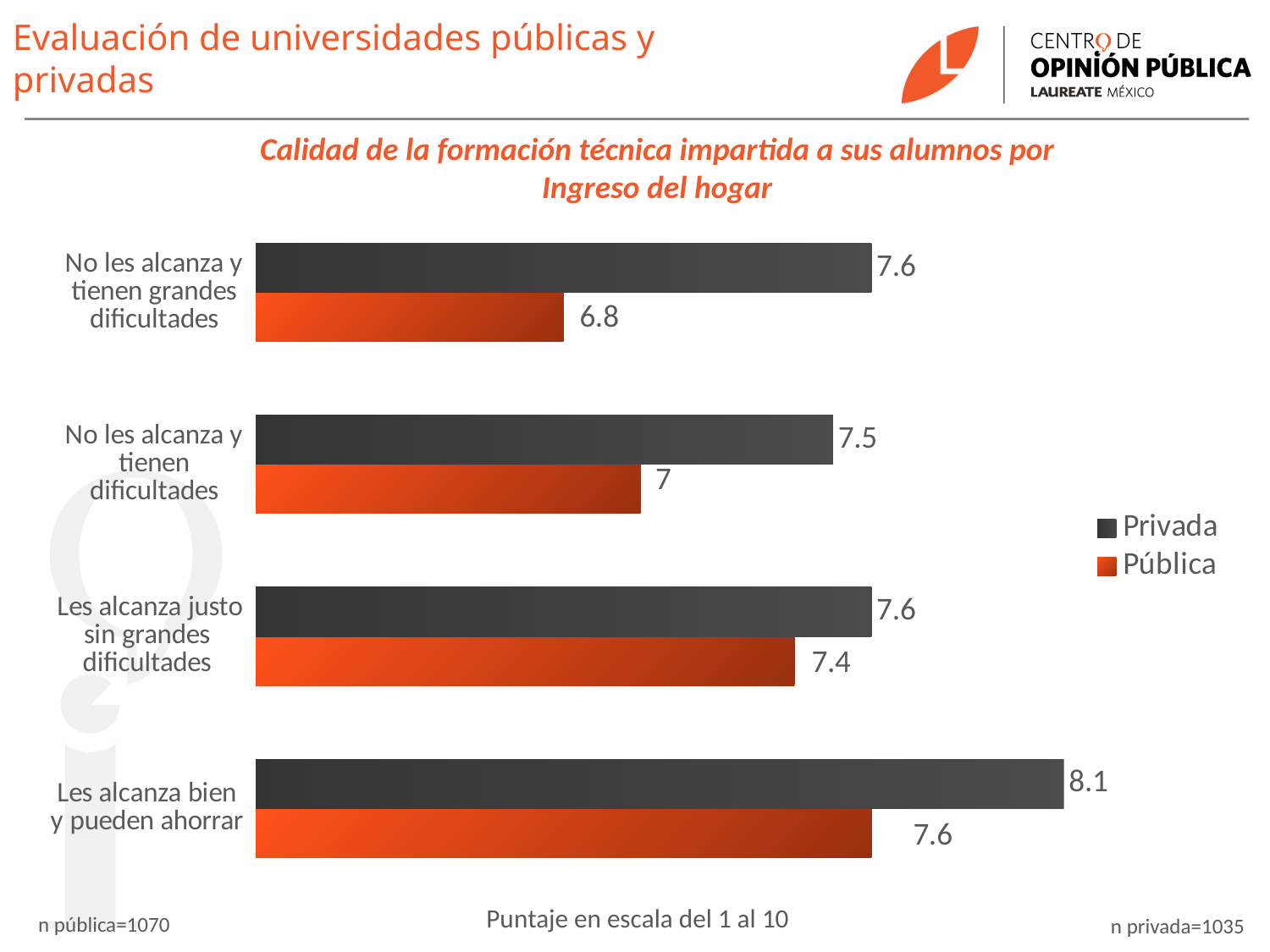
How many series does the legend list? 2 What kind of chart is shown on the slide? Bar chart Which category has the lowest Pública value? No les alcanza y tienen grandes dificultades How many income categories are shown in the chart? 4 What is the Pública value for 'No les alcanza y tienen grandes dificultades'? 6.8 What is the difference between the Privada and Pública values for 'Les alcanza bien y pueden ahorrar'? 0.5 What is the difference between the Privada and Pública values for 'No les alcanza y tienen grandes dificultades'? 0.8 For 'Les alcanza justo sin grandes dificultades', which is larger, the Privada or the Pública value? Privada What is the Privada value for 'Les alcanza bien y pueden ahorrar'? 8.1 What is the Pública value for 'No les alcanza y tienen dificultades'? 7 Which category has the highest Privada value? Les alcanza bien y pueden ahorrar What is the Privada value for 'Les alcanza justo sin grandes dificultades'? 7.6